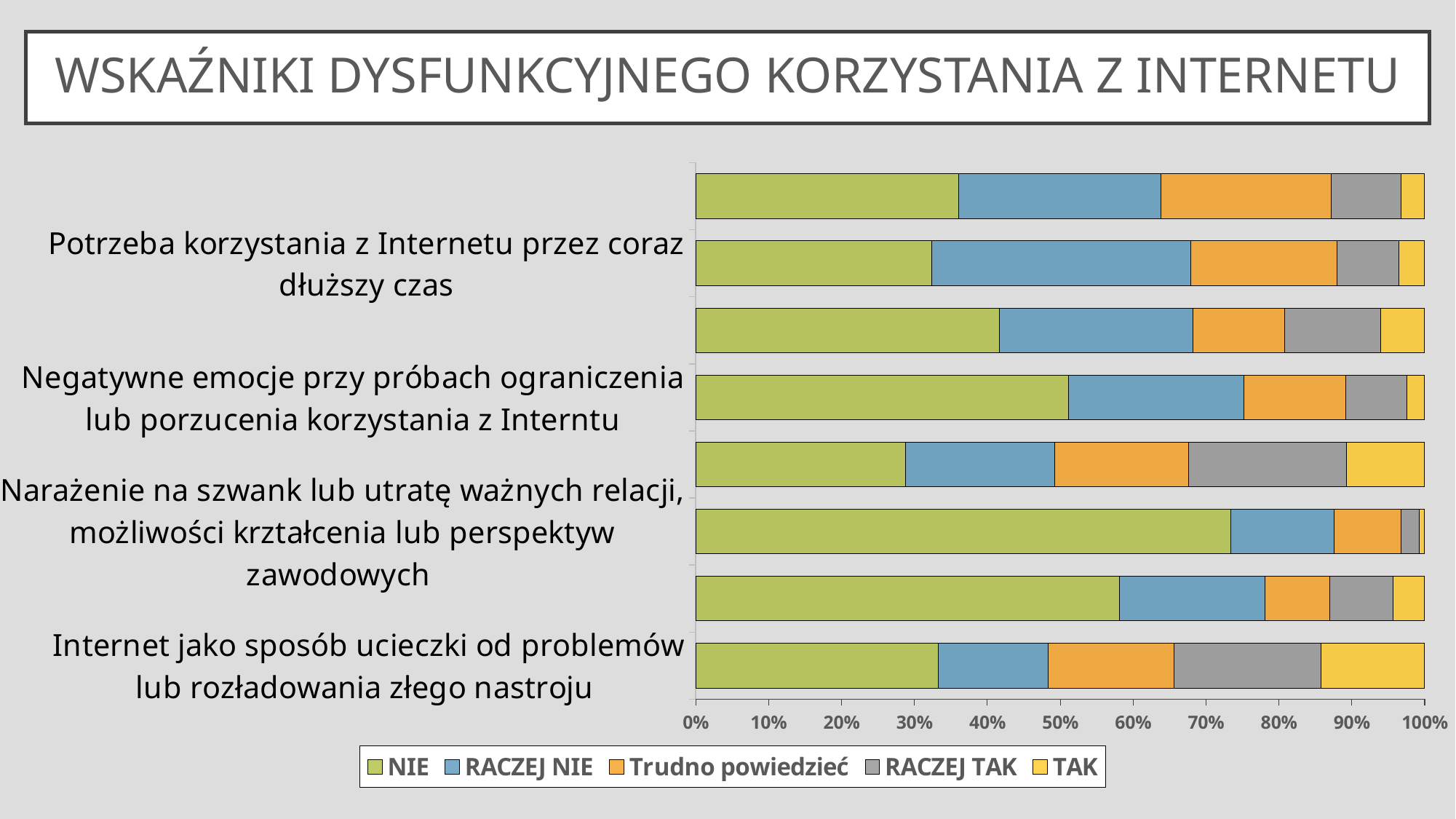
Which bar has the smallest TAK (yellow) segment? the third bar from the bottom What is the title of the slide? WSKAŹNIKI DYSFUNKCYJNEGO KORZYSTANIA Z INTERNETU What type of chart is shown on the slide? stacked bar chart Is the NIE segment of the bottom bar greater or less than 40%? less Is the NIE segment of the third bar from the bottom larger or smaller than the NIE segment of the bottom bar? larger Is the NIE segment of the top bar greater or less than 40%? less What is the maximum value shown on the horizontal axis? 100% Is the NIE segment of the third bar from the bottom greater or less than 70%? greater How many bars are plotted in the chart? 8 Which legend entry is shown in green? NIE How many series does the legend list? 5 Which bar has the largest NIE (green) segment? the third bar from the bottom